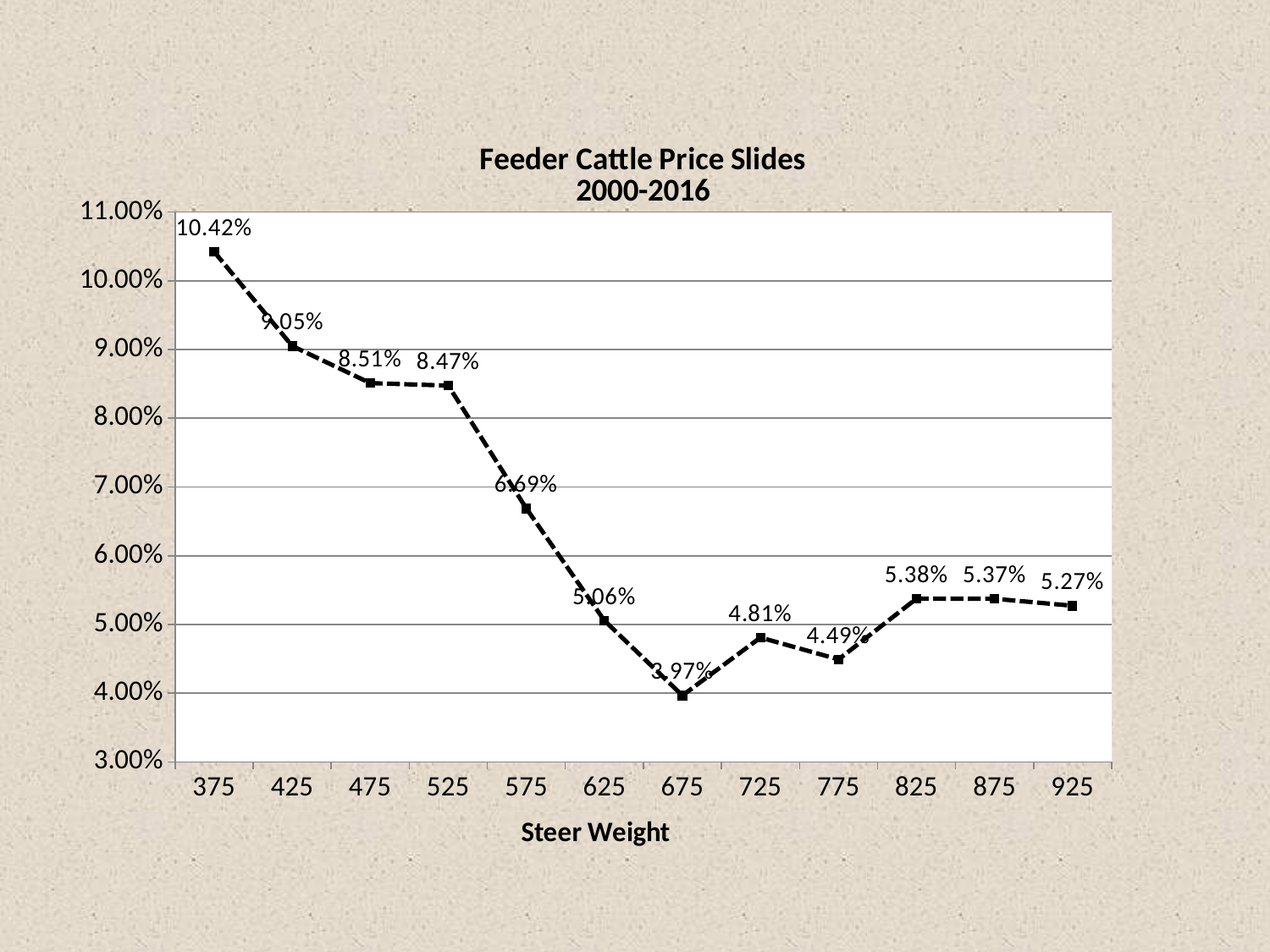
Which is larger, the price slide value at steer weight 725 or at 775? 725 How many steer weight points are plotted on the chart? 12 What is the price slide value for a steer weight of 825? 5.38% What is the difference between the price slide values at steer weights 375 and 675? 6.45% What is the price slide value for a steer weight of 375? 10.42% What is the difference between the price slide values at steer weights 825 and 775? 0.89% Do the price slide values generally rise or fall from steer weight 375 to 675? Fall What kind of chart is shown on the slide? Line chart What is the title of the chart? Feeder Cattle Price Slides 2000-2016 Which steer weight has the lowest price slide value? 675 Which steer weight has the highest price slide value? 375 What is the price slide value for a steer weight of 675? 3.97%